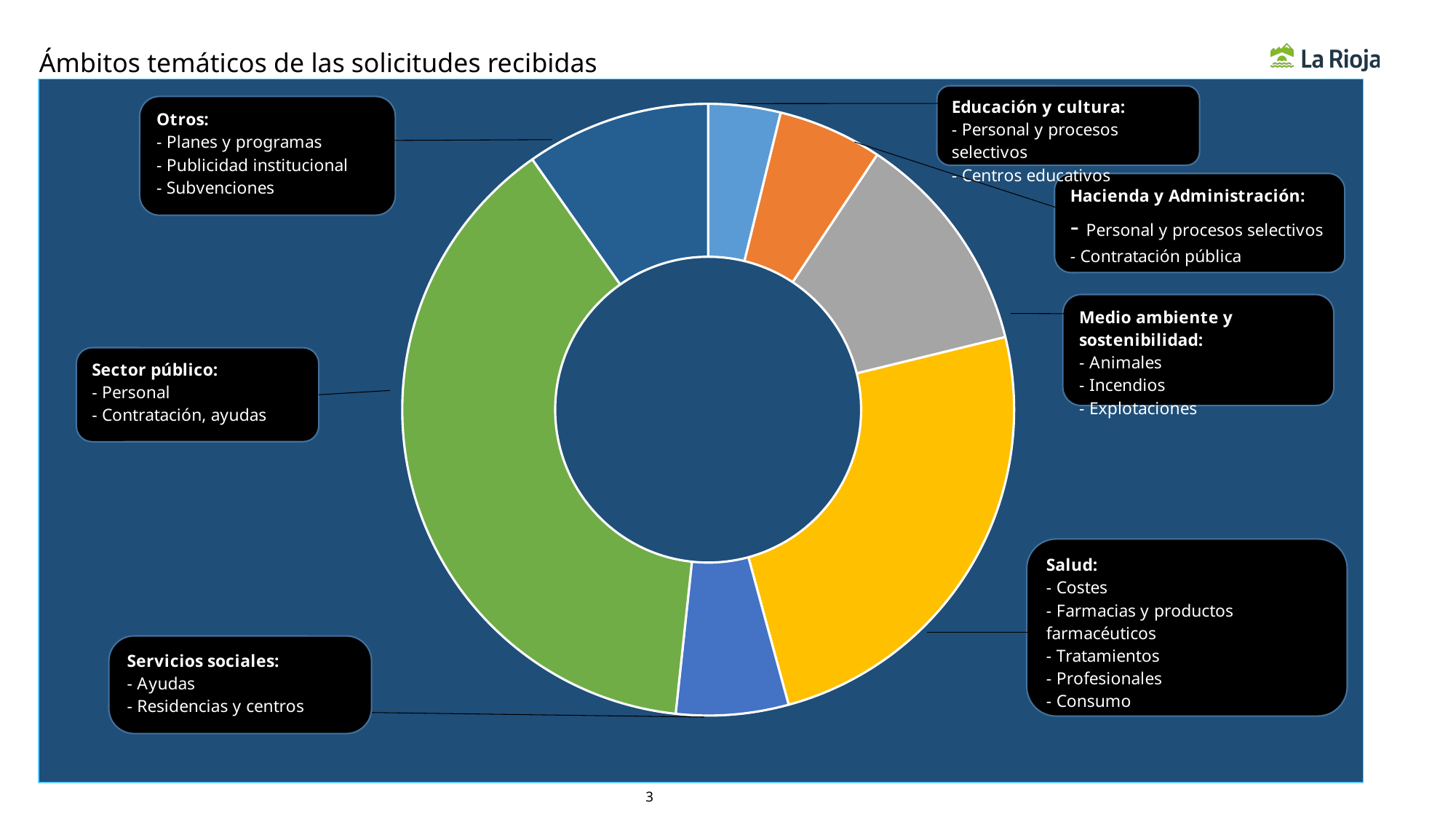
Which is larger, the segment for Otros or the segment for Servicios sociales? Otros Which is larger, the segment for Salud or the segment for Medio ambiente y sostenibilidad? Salud What colour is the segment for Salud in the chart? Yellow How many segments does the doughnut chart have? 7 Which thematic area has the largest segment in the chart? Sector público Which is larger, the segment for Sector público or the segment for Salud? Sector público What kind of chart is shown on the slide? Doughnut (pie) chart What is the title of the slide containing the chart? Ámbitos temáticos de las solicitudes recibidas